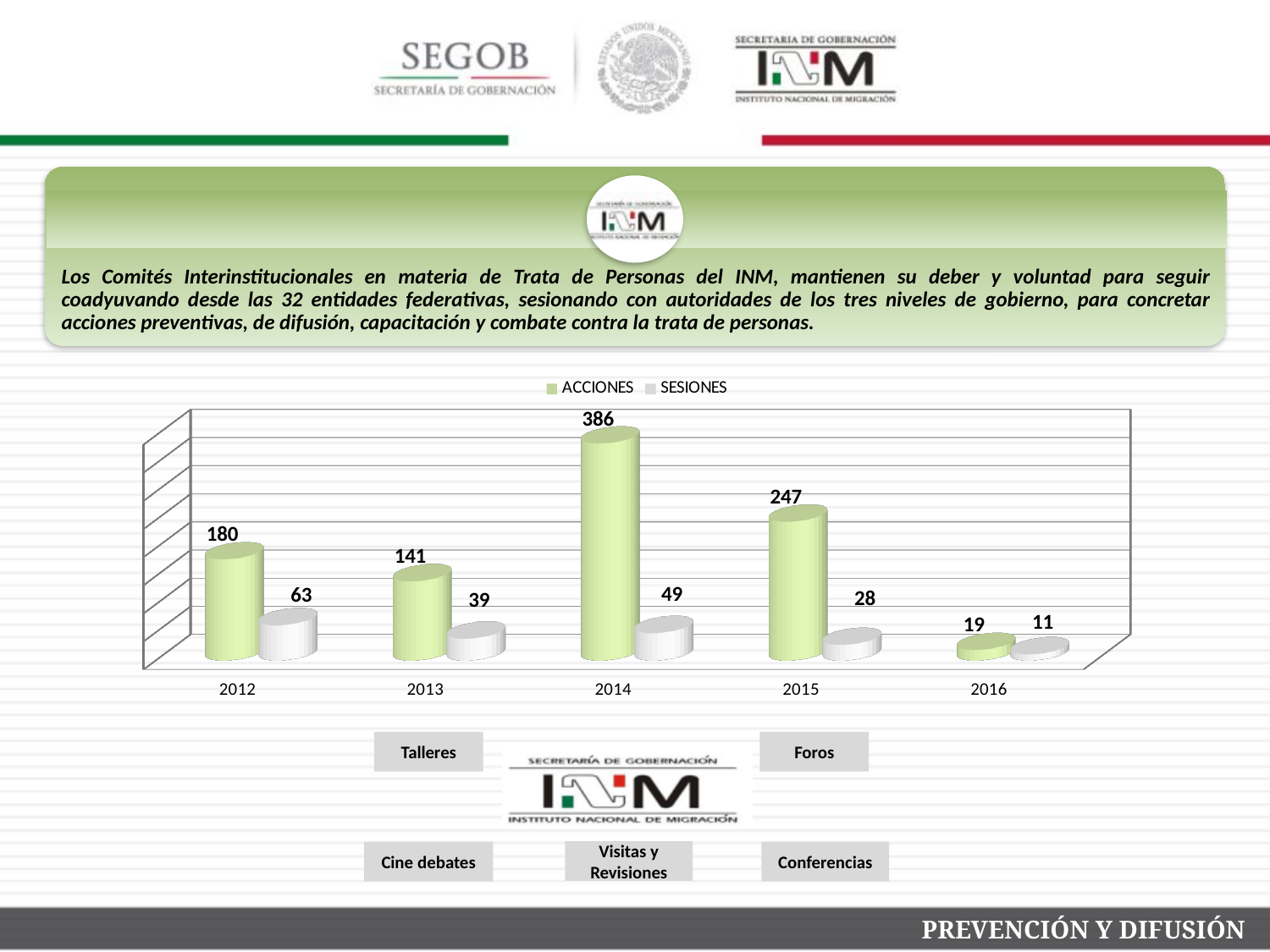
Which is larger, SESIONES in 2013 or SESIONES in 2014? SESIONES in 2014 Which year has the lowest value for SESIONES? 2016 How many years are shown on the x axis? 5 What is the value of ACCIONES for 2014? 386 What is the value of SESIONES for 2012? 63 What is the difference between ACCIONES in 2014 and ACCIONES in 2013? 245 What is the value of ACCIONES for 2016? 19 Which year has the highest value for ACCIONES? 2014 What is the difference between ACCIONES and SESIONES in 2015? 219 What kind of chart is shown on the slide? Bar chart Do the SESIONES values rise or fall from 2014 to 2016? Fall How many series does the legend list? 2